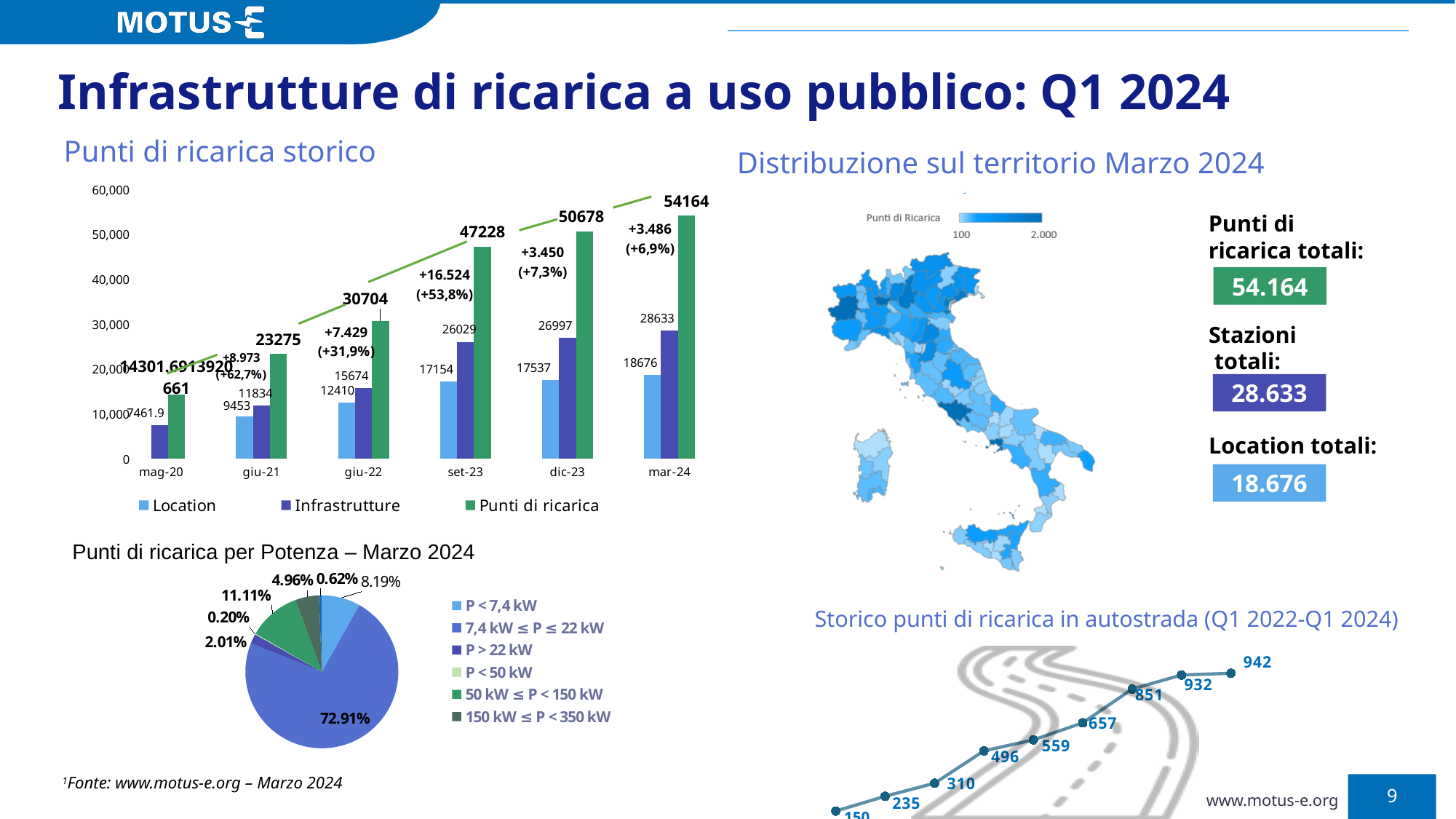
In the line chart 'Storico punti di ricarica in autostrada (Q1 2022-Q1 2024)', what is the highest value shown? 942 In the pie chart 'Punti di ricarica per Potenza – Marzo 2024', what is the share of the largest slice? 72.91% In the 'Punti di ricarica storico' chart, how many time periods are shown on the x axis? 6 In the pie chart 'Punti di ricarica per Potenza – Marzo 2024', how many entries does the legend list? 6 What kind of chart is 'Punti di ricarica storico'? bar chart In the 'Punti di ricarica storico' chart, what is the Infrastrutture value for dic-23? 26997 In the 'Punti di ricarica storico' chart, what is the difference between the Punti di ricarica values for mar-24 and dic-23? 3486 In the 'Punti di ricarica storico' chart, what is the Location value for giu-22? 12410 In the 'Punti di ricarica storico' chart, which is larger: Infrastrutture for set-23 or Location for mar-24? Infrastrutture for set-23 In the line chart 'Storico punti di ricarica in autostrada (Q1 2022-Q1 2024)', do the values rise or fall from left to right? rise In the 'Punti di ricarica storico' chart, how many series does the legend list? 3 In the 'Punti di ricarica storico' chart, what is the value of Punti di ricarica for mar-24? 54164